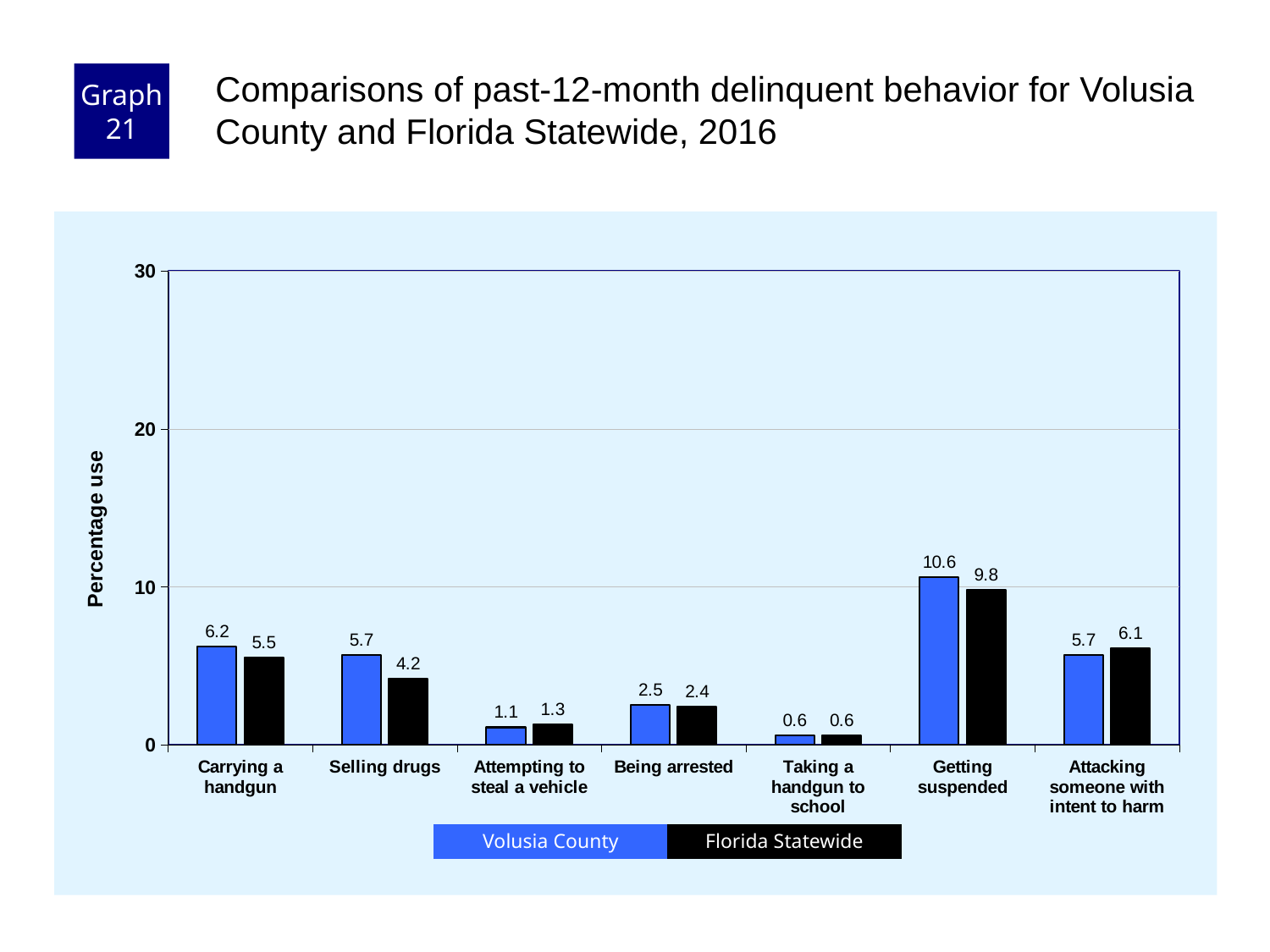
What is the Florida Statewide value for Selling drugs? 4.2 How many series does the legend list? 2 How many categories are shown on the x axis? 7 What is the Volusia County value for Being arrested? 2.5 What is the difference between the Volusia County and Florida Statewide values for Getting suspended? 0.8 For Attacking someone with intent to harm, which is larger: Volusia County or Florida Statewide? Florida Statewide What is the difference between the Volusia County and Florida Statewide values for Selling drugs? 1.5 What kind of chart is shown on the slide? bar chart Is the Volusia County value for Getting suspended greater or less than 10? greater What is the Volusia County value for Getting suspended? 10.6 Which category has the lowest Volusia County value? Taking a handgun to school Which category has the highest Florida Statewide value? Getting suspended